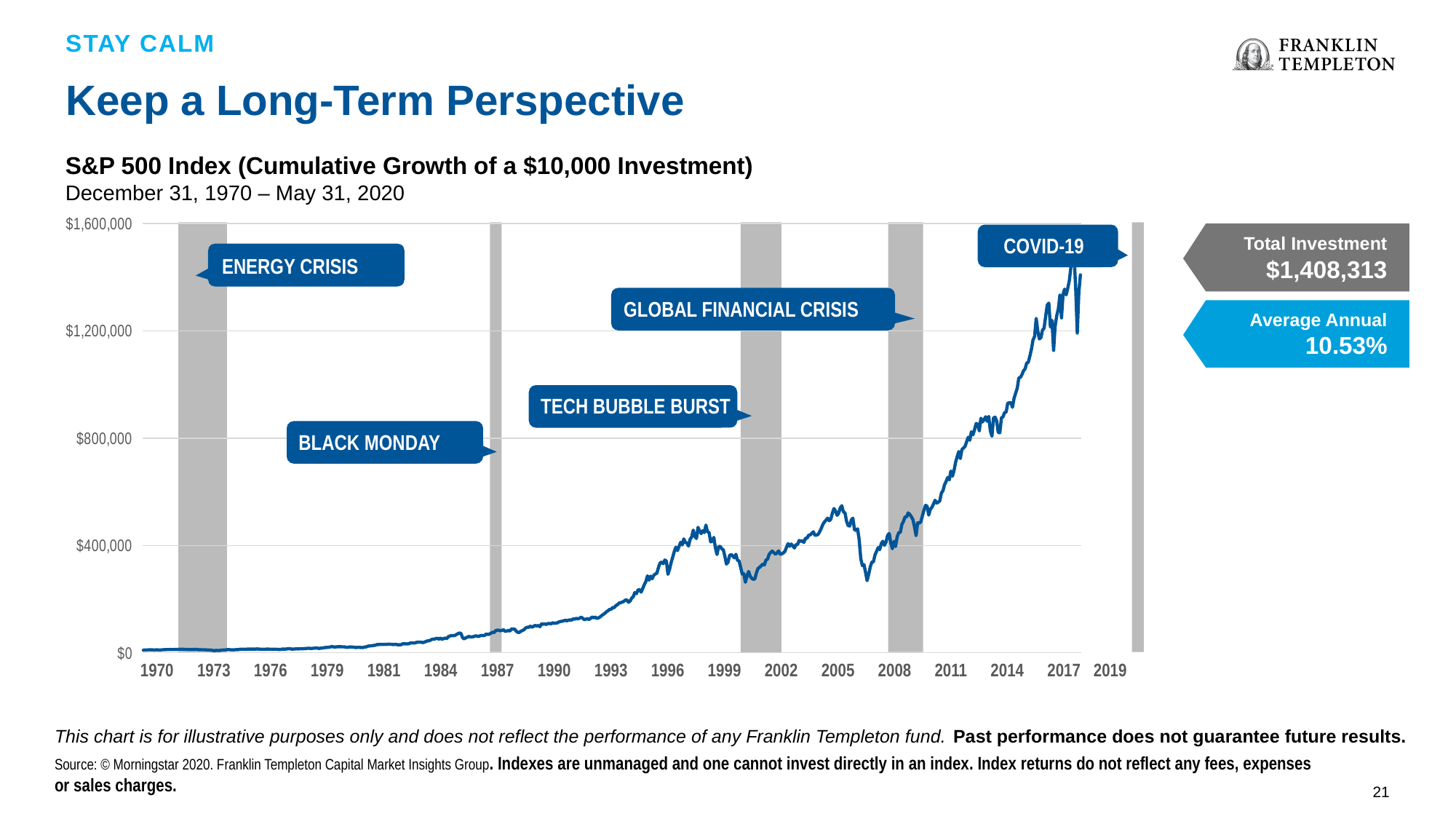
What is the highest value shown on the y axis? $1,600,000 Does the value of the investment generally rise or fall from 1970 to 2020? rise What is the Average Annual return shown on the slide? 10.53% How many market events are labelled with callouts on the chart? 5 What is the title of the chart? S&P 500 Index (Cumulative Growth of a $10,000 Investment) What date range does the chart cover? December 31, 1970 – May 31, 2020 What is the Total Investment value shown on the slide? $1,408,313 What kind of chart is shown on the slide? line chart Is the value of the investment in 2017 greater or less than $1,200,000? less Is the value of the investment in 1990 greater or less than $400,000? less Is the value of the investment in 1984 greater or less than $400,000? less